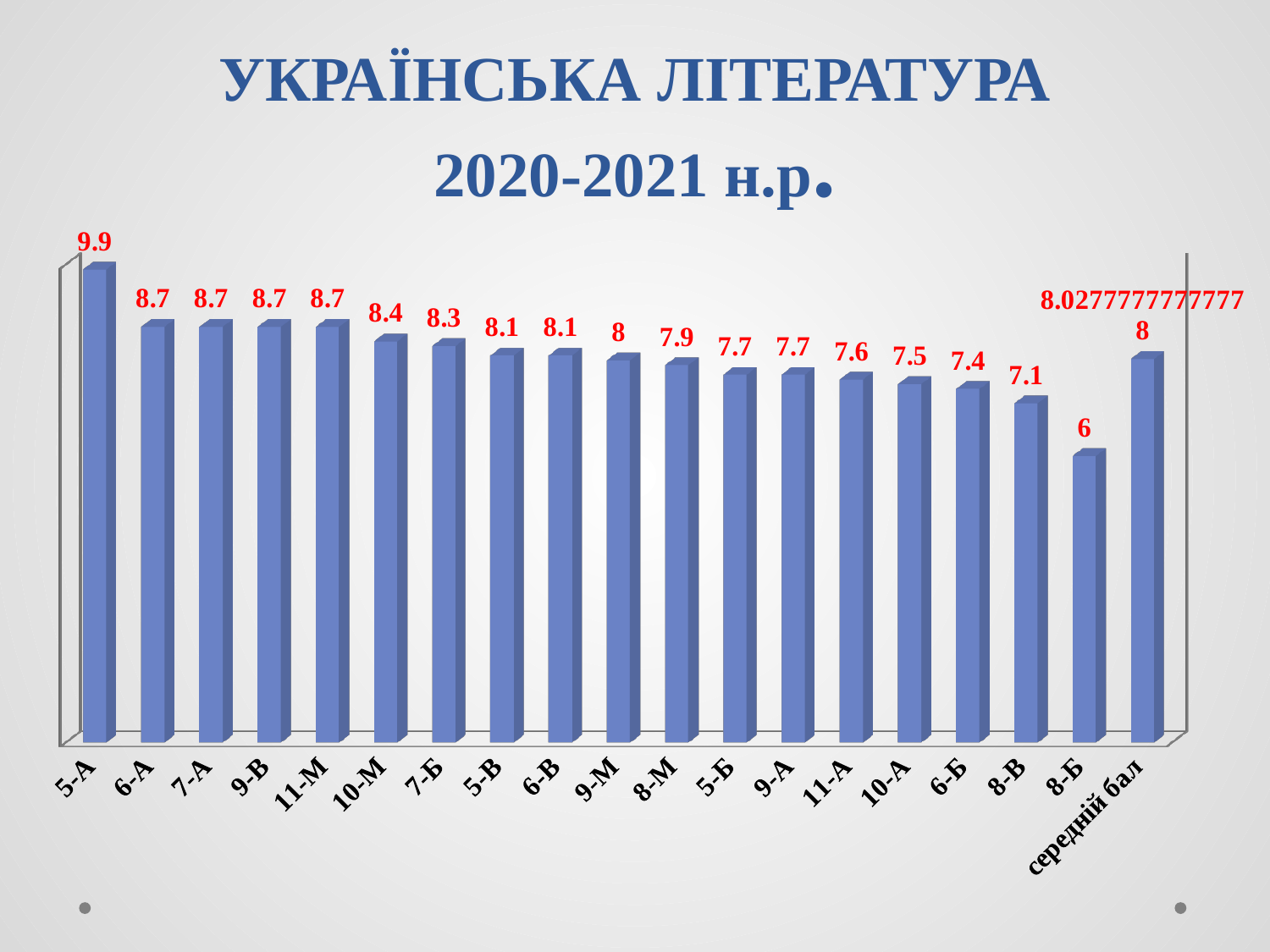
What is the value for 8-Б? 6 Do the values rise or fall along the x axis from 5-А to 8-Б? fall What is the difference between the values for 5-А and 8-Б? 3.9 What kind of chart is shown on the slide? bar chart Which category has the lowest value? 8-Б What is the value for 11-А? 7.6 How many bars are shown in the chart? 19 What is the value for 5-А? 9.9 What is the value for 10-М? 8.4 Which has the larger value, 7-Б or 8-М? 7-Б What is the title of the slide? УКРАЇНСЬКА ЛІТЕРАТУРА 2020-2021 н.р. Which category has the highest value? 5-А